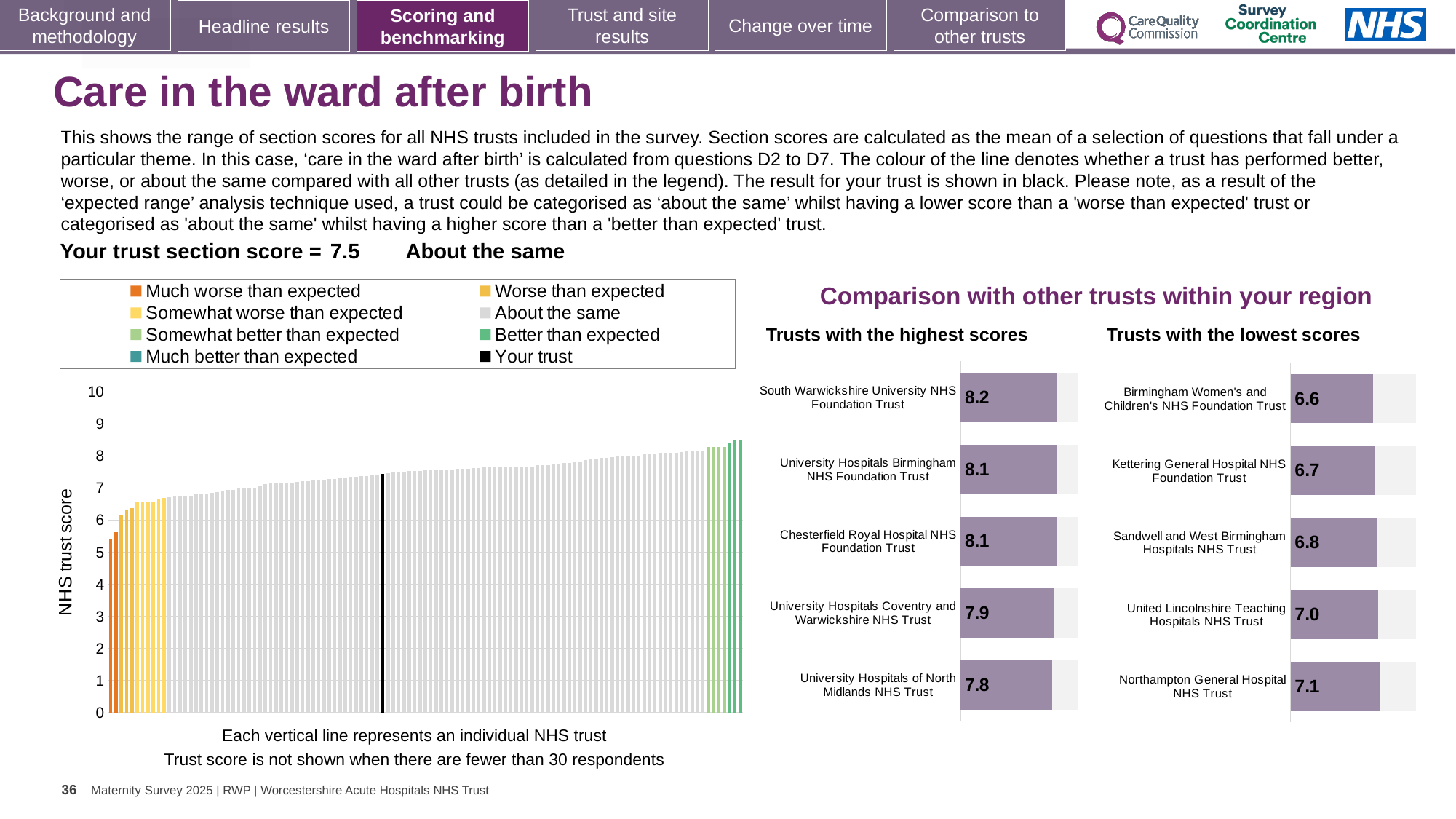
In the large chart on the left, is the value for the black bar (Your trust) greater or less than 7? greater How many trusts are shown in the 'Trusts with the highest scores' chart? 5 In the large chart on the left, do the trust scores rise or fall from left to right? rise What kind of chart is the large chart on the left showing NHS trust scores? bar chart In the 'Trusts with the highest scores' chart, which trust has the lowest score? University Hospitals of North Midlands NHS Trust In the 'Trusts with the highest scores' chart, what is the difference between the scores of South Warwickshire University NHS Foundation Trust and University Hospitals of North Midlands NHS Trust? 0.4 In the 'Trusts with the highest scores' chart, what is the score for South Warwickshire University NHS Foundation Trust? 8.2 How many entries does the legend above the large chart on the left list? 8 In the 'Trusts with the lowest scores' chart, which has the larger score: Birmingham Women's and Children's NHS Foundation Trust or United Lincolnshire Teaching Hospitals NHS Trust? United Lincolnshire Teaching Hospitals NHS Trust In the 'Trusts with the lowest scores' chart, what is the score for Kettering General Hospital NHS Foundation Trust? 6.7 In the 'Trusts with the lowest scores' chart, which trust has the highest score? Northampton General Hospital NHS Trust What is the title of the section containing the two small bar charts on the right? Comparison with other trusts within your region